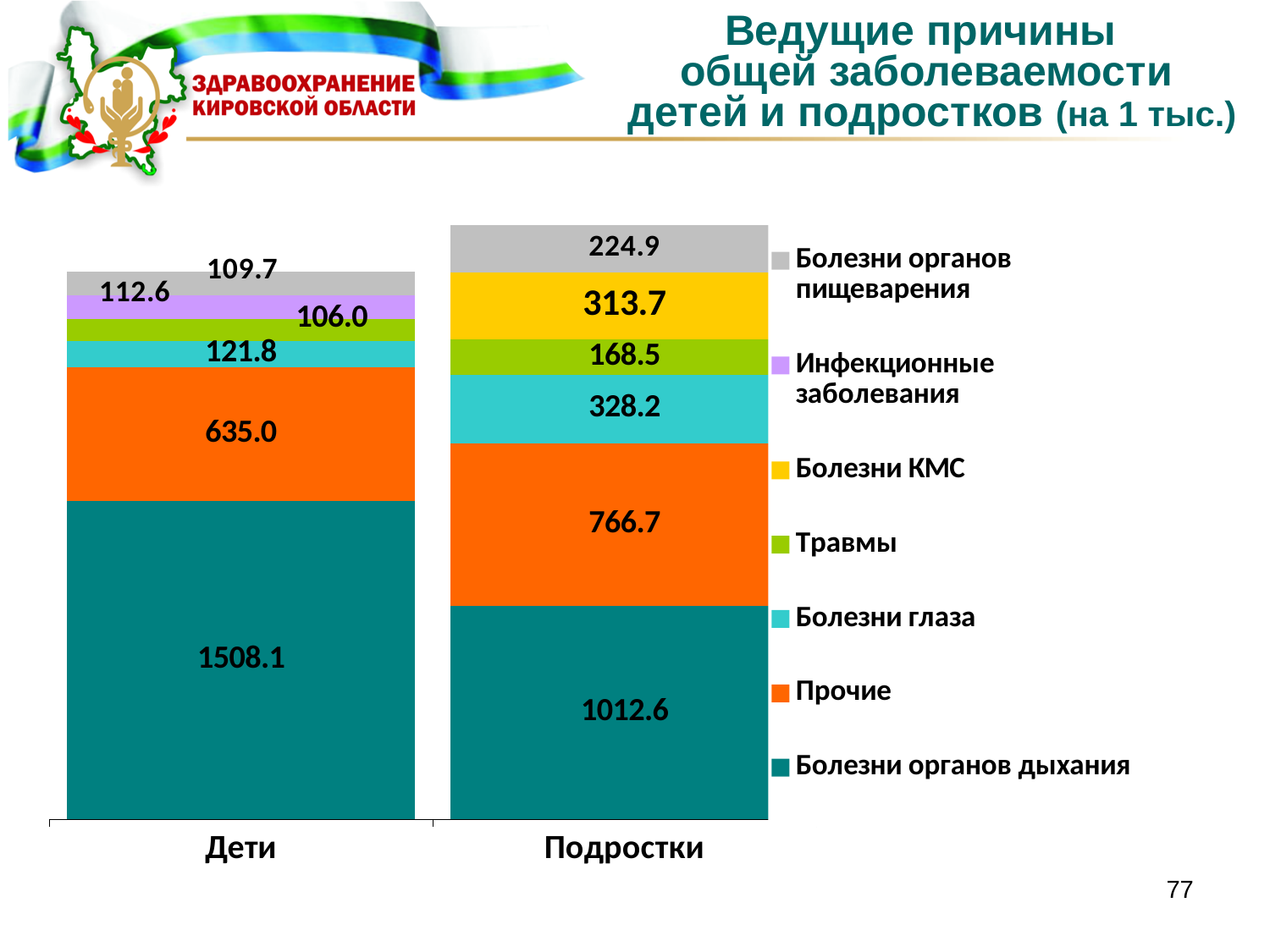
What is the value for Болезни КМС in the Подростки bar? 313.7 Which is larger: Прочие for Дети or Прочие for Подростки? Подростки What is the value for Болезни органов дыхания in the Дети bar? 1508.1 What is the value for Прочие in the Подростки bar? 766.7 What is the value for Болезни глаза in the Дети bar? 121.8 How many categories are shown on the x axis? 2 What is the difference between Болезни органов дыхания for Дети and for Подростки? 495.5 What type of chart is shown on the slide? stacked bar chart Which legend entry is shown in orange? Прочие What is the total of the Подростки stacked bar? 2814.6 How many series does the legend list? 7 What is the value for Болезни органов дыхания in the Подростки bar? 1012.6